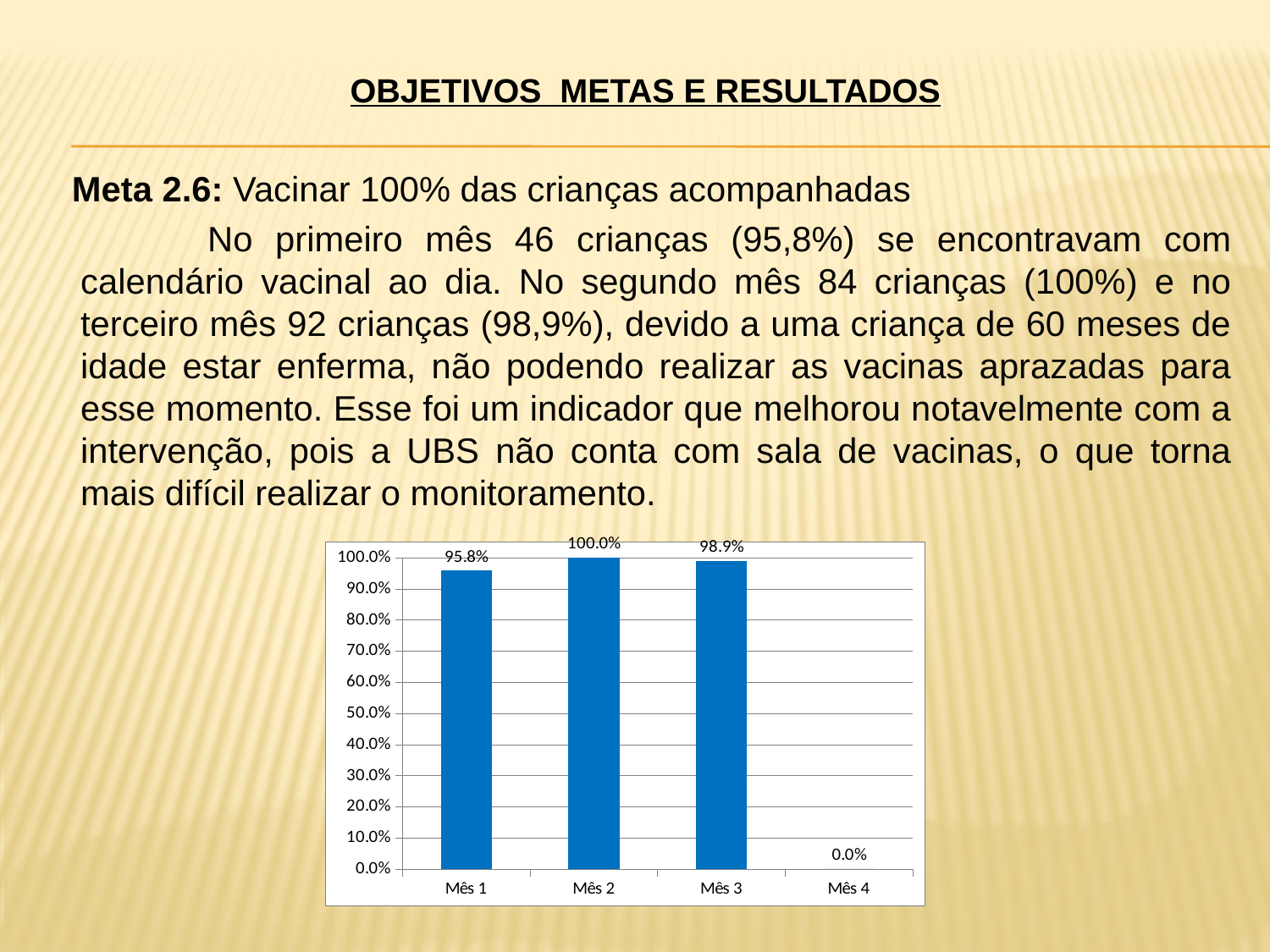
How many categories are shown on the x axis? 4 Is the value for Mês 1 greater or less than 90.0%? greater What is the value for Mês 2? 100.0% What is the value for Mês 3? 98.9% Which category has the highest value? Mês 2 What is the difference between the values for Mês 2 and Mês 1? 4.2% What is the value for Mês 4? 0.0% What is the difference between the values for Mês 3 and Mês 1? 3.1% Which is larger, the value for Mês 1 or the value for Mês 3? Mês 3 What kind of chart is shown on the slide? bar chart Which category has the lowest value? Mês 4 What is the value for Mês 1? 95.8%